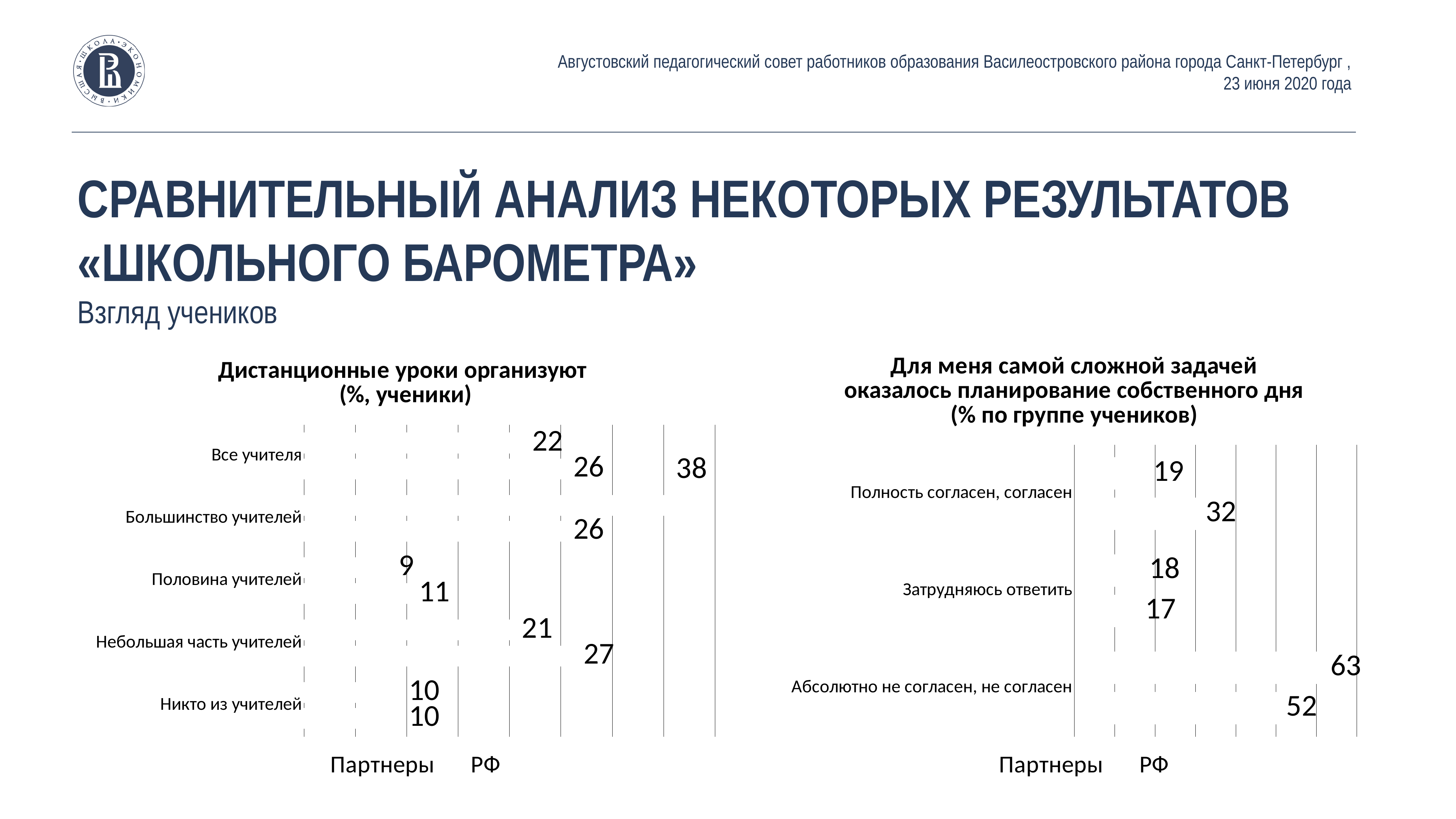
What kind of chart is the left chart (Дистанционные уроки организуют)? Bar chart On the right chart (Для меня самой сложной задачей...), which category has the highest value for Партнеры? Абсолютно не согласен, не согласен On the left chart (Дистанционные уроки организуют), what is the difference between the РФ and Партнеры values for Небольшая часть учителей? 6 On the left chart (Дистанционные уроки организуют), which is larger for Половина учителей: Партнеры or РФ? РФ On the right chart (Для меня самой сложной задачей...), how many series does the legend list? 2 On the right chart (Для меня самой сложной задачей...), what is the difference between the Партнеры and РФ values for Абсолютно не согласен, не согласен? 11 On the right chart (Для меня самой сложной задачей...), what is the value for РФ for Полность согласен, согласен? 32 On the left chart (Дистанционные уроки организуют), what is the value for Партнеры for Половина учителей? 9 On the right chart (Для меня самой сложной задачей...), what is the value for Партнеры for Абсолютно не согласен, не согласен? 63 On the left chart (Дистанционные уроки организуют), what is the value for Партнеры for Все учителя? 22 On the left chart (Дистанционные уроки организуют), what is the value for РФ for Небольшая часть учителей? 27 On the left chart (Дистанционные уроки организуют), how many categories are listed on the vertical axis? 5